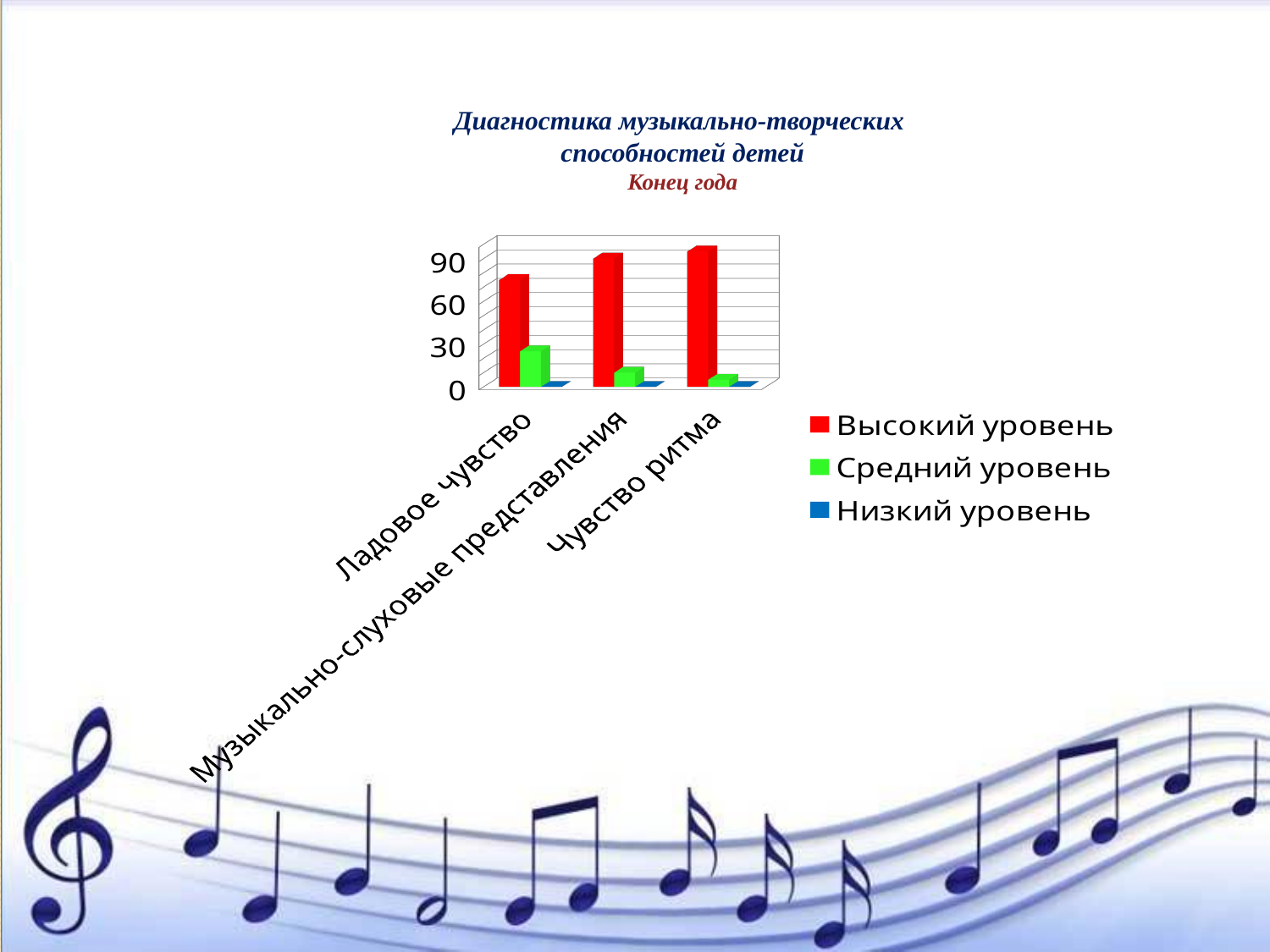
What period does the subtitle of the chart refer to? Конец года Is the value for Средний уровень in Чувство ритма greater or less than 30? less How many categories are shown on the x axis of the chart? 3 How many series does the chart legend list? 3 In the category Ладовое чувство, which is larger: Высокий уровень or Средний уровень? Высокий уровень Is the value for Высокий уровень in Музыкально-слуховые представления greater or less than 60? greater Which category has the lowest value for Средний уровень? Чувство ритма Which series is shown in red in the chart? Высокий уровень What kind of chart is shown on the slide? bar chart Which category has the lowest value for Высокий уровень? Ладовое чувство Is the value for Высокий уровень in Ладовое чувство greater or less than 60? greater Which category has the highest value for Средний уровень? Ладовое чувство